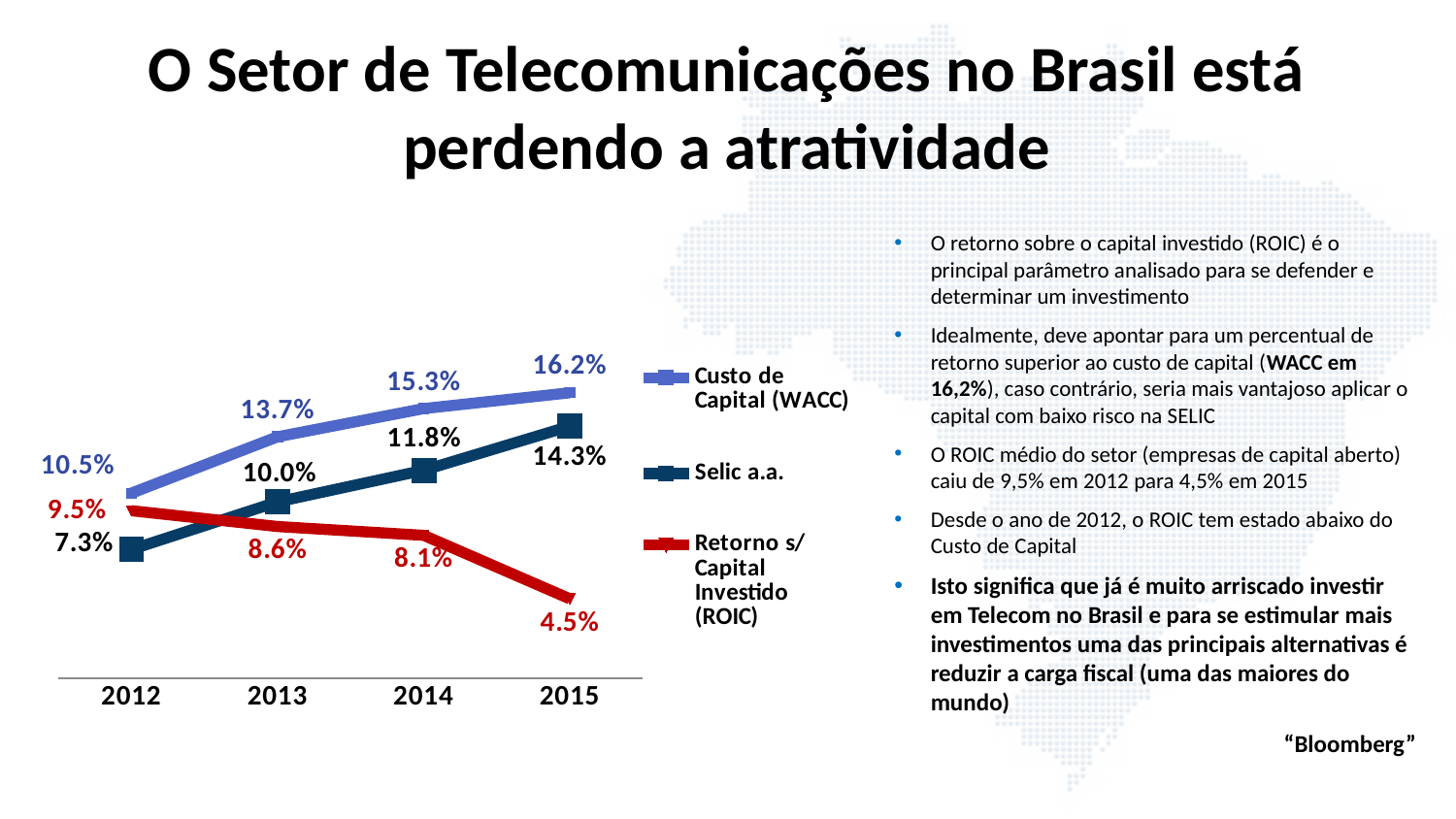
What is the difference between Custo de Capital (WACC) and ROIC in 2015? 11.7% How many years are shown on the x axis of the chart? 4 In which year is the Custo de Capital (WACC) series at its highest value? 2015 Which is larger in 2012: Selic a.a. or ROIC? ROIC What is the value of Retorno s/ Capital Investido (ROIC) in 2014? 8.1% In which year is the ROIC series at its lowest value? 2015 What type of chart is shown on the slide? line chart What colour is the line for Selic a.a.? dark blue What is the value of Custo de Capital (WACC) in 2015? 16.2% How many series does the chart legend list? 3 What is the value of Selic a.a. in 2013? 10.0% Does the ROIC series rise or fall from 2012 to 2015? fall